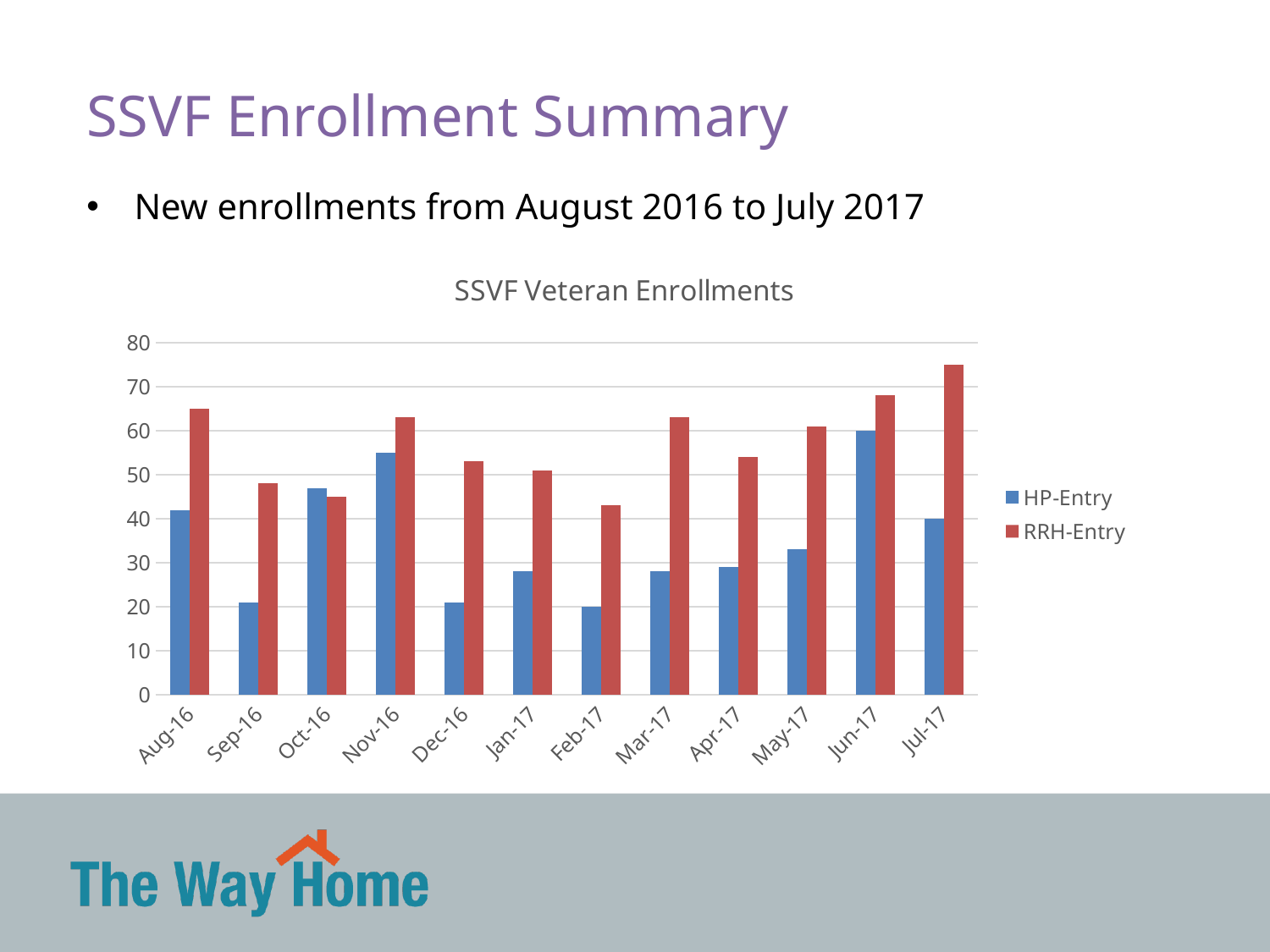
In Aug-16, which is larger, HP-Entry or RRH-Entry? RRH-Entry What is the title of the chart? SSVF Veteran Enrollments Is the RRH-Entry value for Jul-17 greater or less than 70? greater What kind of chart is shown on the slide? bar chart How many series does the legend list? 2 Which month has the highest HP-Entry value? Jun-17 Is the RRH-Entry value for Feb-17 greater or less than 50? less How many months are shown on the x axis? 12 Which series is shown in red? RRH-Entry Is the HP-Entry value for Nov-16 greater or less than 50? greater Which month has the highest RRH-Entry value? Jul-17